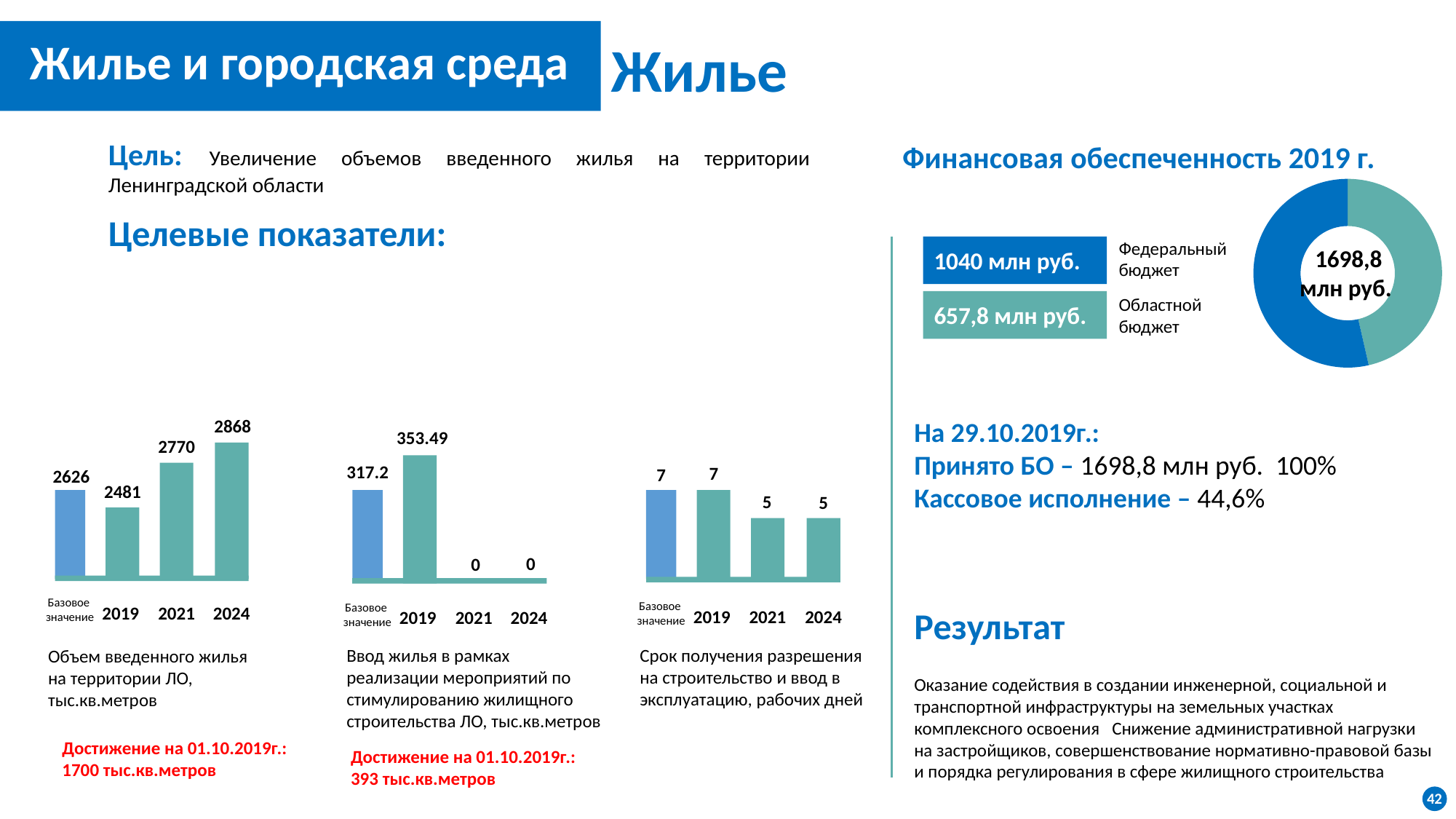
In the middle bar chart (Ввод жилья в рамках реализации мероприятий), what is the base value (Базовое значение)? 317.2 What type of chart is used for Финансовая обеспеченность 2019 г.? Donut (pie) chart In the donut chart (Финансовая обеспеченность 2019 г.), what is the value for Федеральный бюджет? 1040 млн руб. In the left bar chart (Объем введенного жилья на территории ЛО), what is the difference between the 2024 value and the 2021 value? 98 In the right bar chart (Срок получения разрешения на строительство), what is the value for 2021? 5 In the middle bar chart (Ввод жилья в рамках реализации мероприятий), which category has the highest value? 2019 How many categories are shown in the right bar chart (Срок получения разрешения на строительство)? 4 In the right bar chart (Срок получения разрешения на строительство), is the value for 2019 larger or smaller than the value for 2024? larger In the left bar chart (Объем введенного жилья на территории ЛО), what is the value for 2019? 2481 In the middle bar chart (Ввод жилья в рамках реализации мероприятий), what is the value for 2019? 353.49 In the left bar chart (Объем введенного жилья на территории ЛО), what is the value for 2024? 2868 In the left bar chart (Объем введенного жилья на территории ЛО), which category has the lowest value? 2019